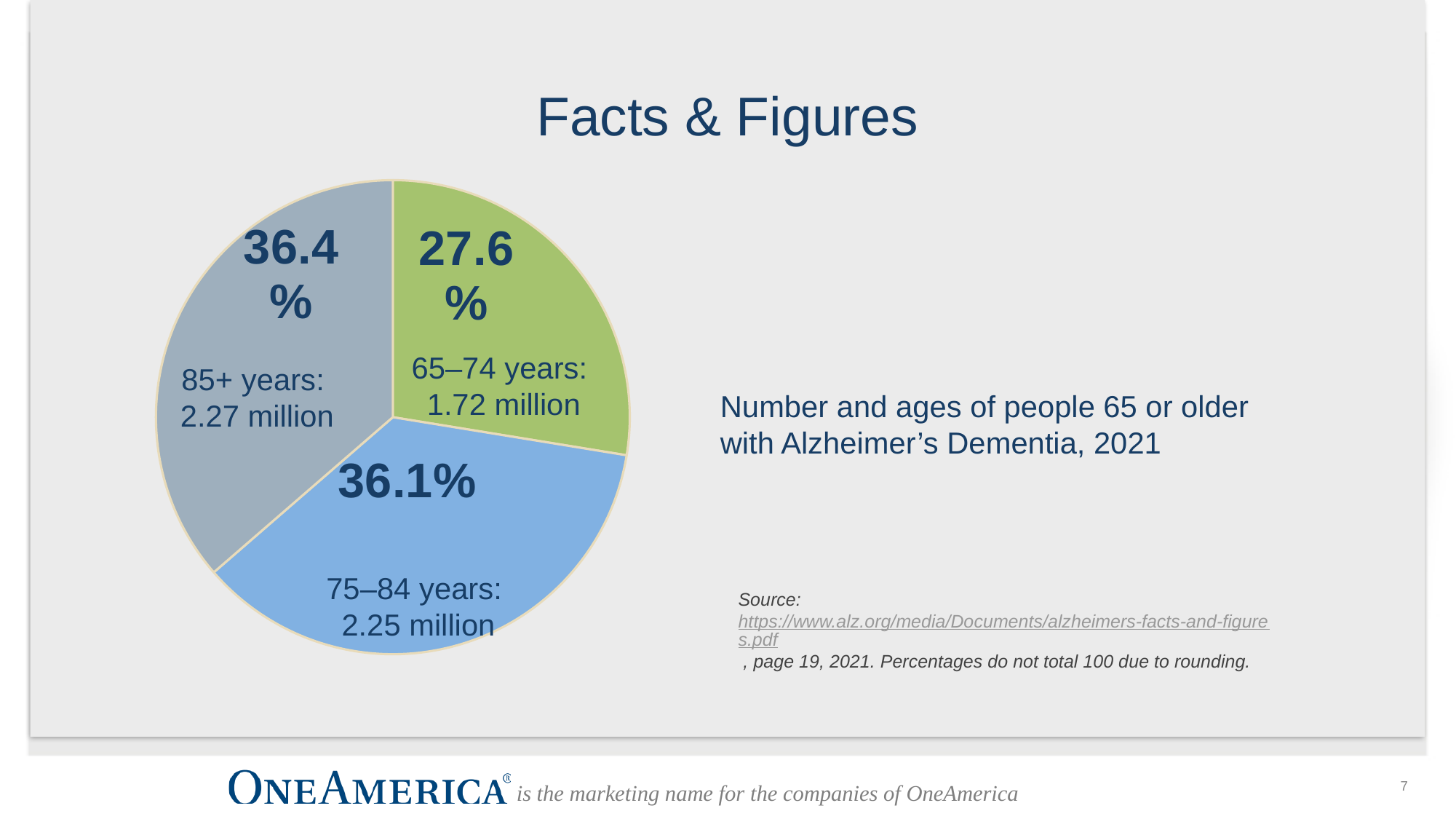
What colour is the 65–74 years slice of the pie chart? Green How many people aged 85+ years are shown in the pie chart? 2.27 million How many slices does the pie chart have? 3 What percentage of the pie is the 85+ years slice? 36.4% What type of chart is shown on the slide? Pie chart Which is larger: the number of people aged 65–74 years or the number aged 75–84 years? 75–84 years How many people aged 65–74 years are shown in the pie chart? 1.72 million What percentage of the pie is the 75–84 years slice? 36.1% What percentage of the pie is the 65–74 years slice? 27.6% How many people aged 75–84 years are shown in the pie chart? 2.25 million Which age group has the smallest slice of the pie chart? 65–74 years Which age group has the largest slice of the pie chart? 85+ years